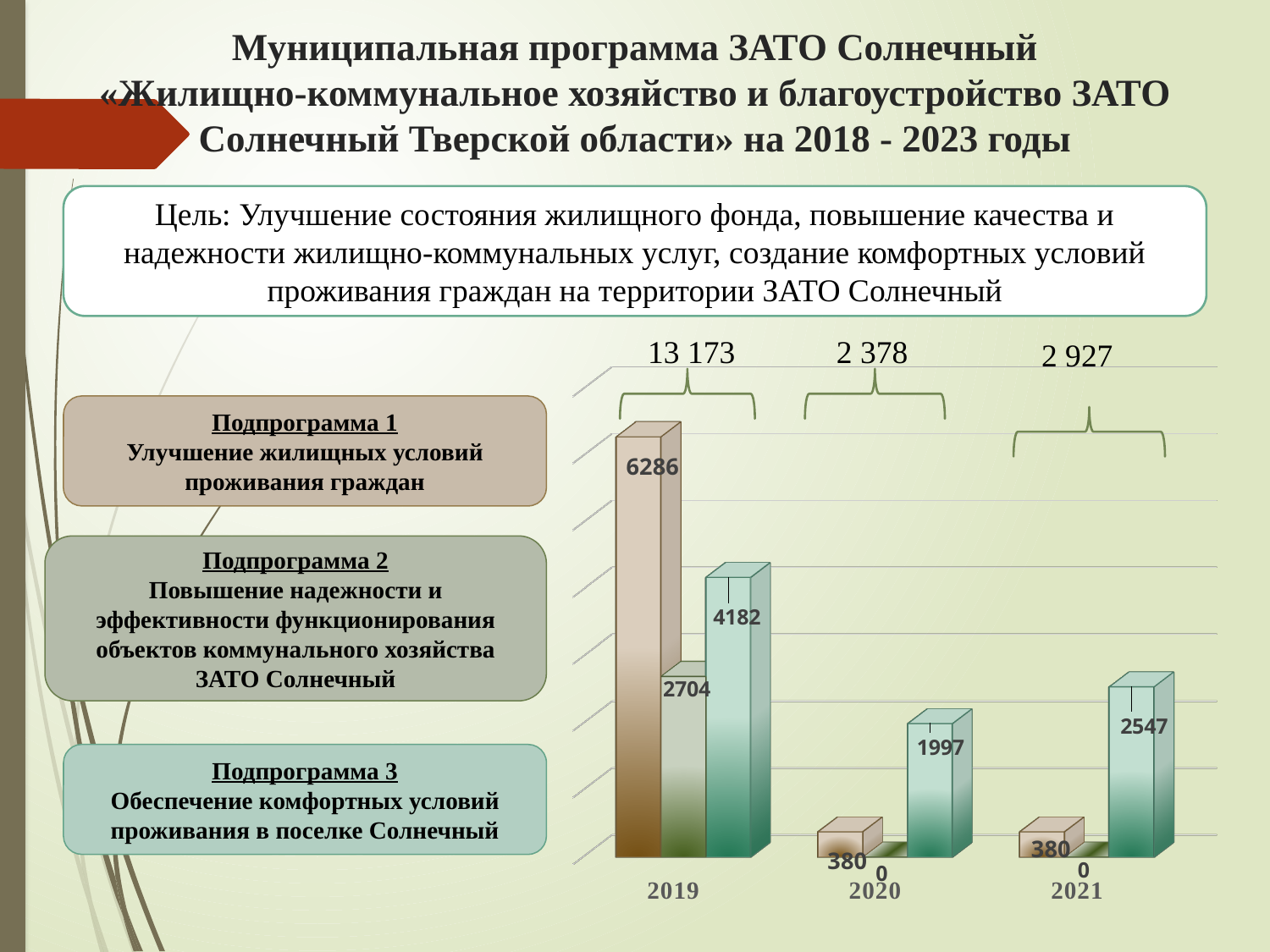
What total is printed above the 2021 group of bars? 2 927 What is the value of the Подпрограмма 3 (teal) bar for 2021? 2547 Which is larger: the 2019 bar labelled 4182 or the 2019 bar labelled 2704? 4182 What is the value of the tallest bar for 2019? 6286 What is the difference between the Подпрограмма 3 values for 2021 and 2020 (2547 and 1997)? 550 What value is shown for Подпрограмма 2 in 2020 and 2021? 0 What is the value of the Подпрограмма 3 (teal) bar for 2020? 1997 What type of chart is shown on the slide? bar chart How many years are shown on the x axis of the chart? 3 What total is printed above the 2019 group of bars? 13 173 What is the value of the Подпрограмма 1 (beige) bar for 2020? 380 Which year has the highest total printed above its bars? 2019